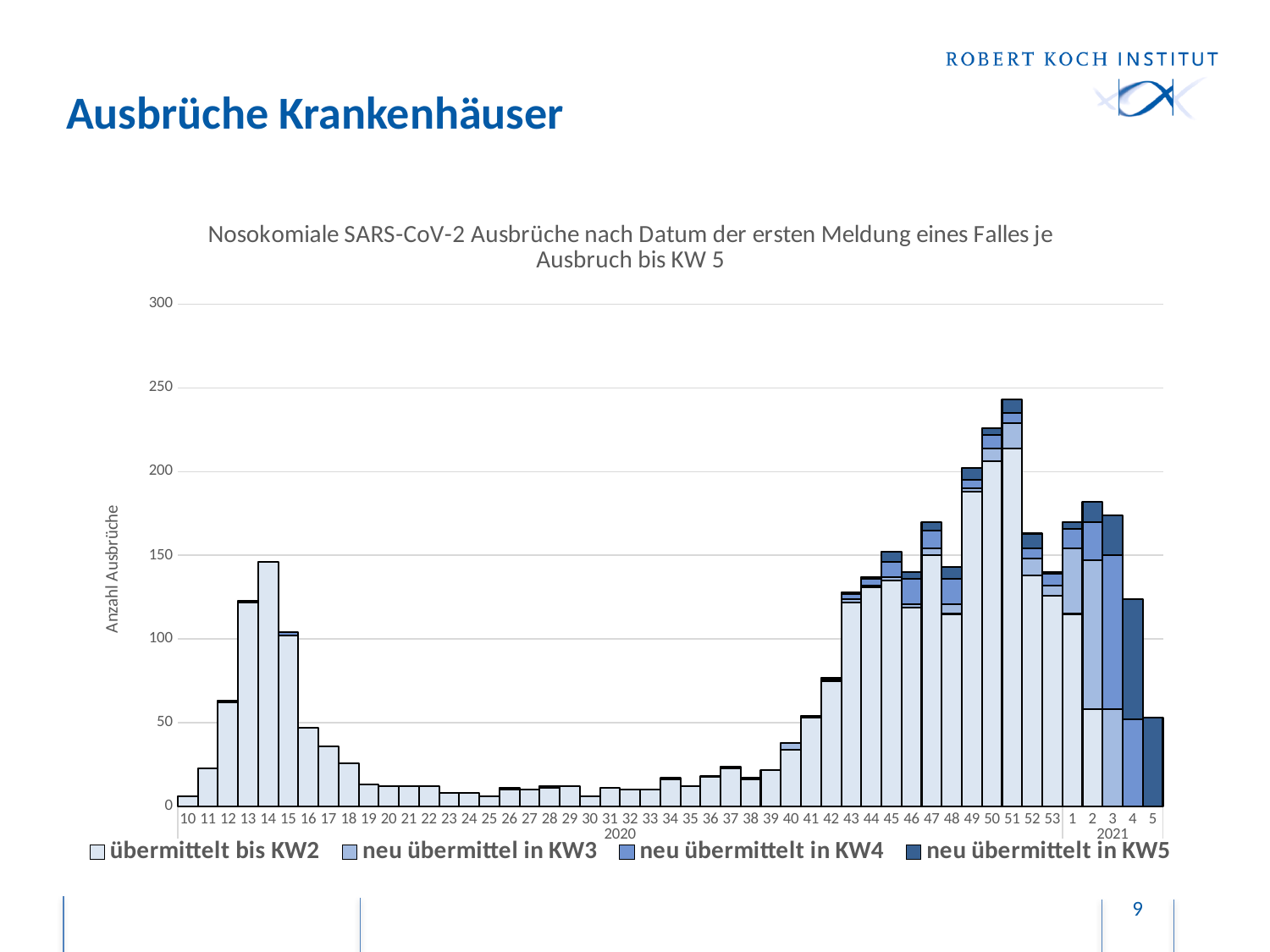
Is the total value for KW 42 of 2020 greater or less than 100? less Do the totals rise or fall from KW 40 to KW 51 of 2020? rise How many series does the legend list? 4 Is the total value for KW 51 of 2020 greater or less than 200? greater Which has the larger total: KW 14 of 2020 or KW 15 of 2020? KW 14 of 2020 What kind of chart is shown on the slide? Stacked bar chart Is the total value for KW 20 of 2020 greater or less than 50? less What is the title of the chart? Nosokomiale SARS-CoV-2 Ausbrüche nach Datum der ersten Meldung eines Falles je Ausbruch bis KW 5 What is the label of the y axis? Anzahl Ausbrüche Which calendar week has the highest total number of outbreaks? KW 51 (2020) How many calendar-week bars are plotted in total (2020 and 2021 combined)? 49